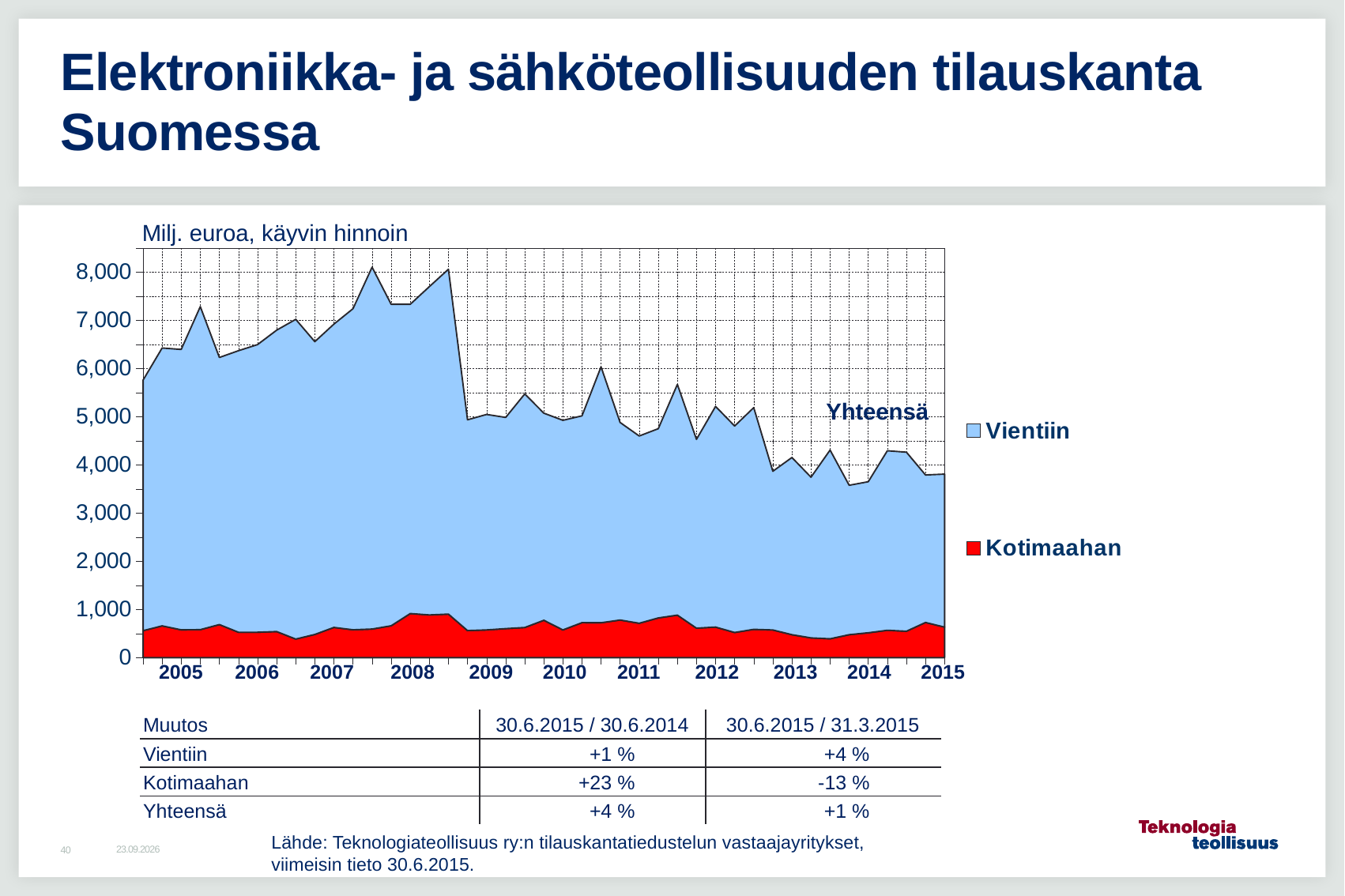
What kind of chart is shown on the slide? Stacked area chart Is the peak total (Yhteensä) value reached around 2007 greater or less than 7,000? greater Does the total order book (Yhteensä) generally rise or fall from 2005 to 2015? fall Is the total (Yhteensä) value at the start of 2005 greater or less than 5,000? greater How many year labels are shown on the x axis of the chart? 11 Which series, Vientiin or Kotimaahan, accounts for the larger part of the total order book throughout the chart? Vientiin What is the highest value labelled on the chart's y axis? 8,000 What are the two series named in the chart legend? Vientiin and Kotimaahan Is the total (Yhteensä) value at the end of the series in 2015 greater or less than 4,000? less How many series does the chart legend list? 2 What unit label is shown above the chart's y axis? Milj. euroa, käyvin hinnoin